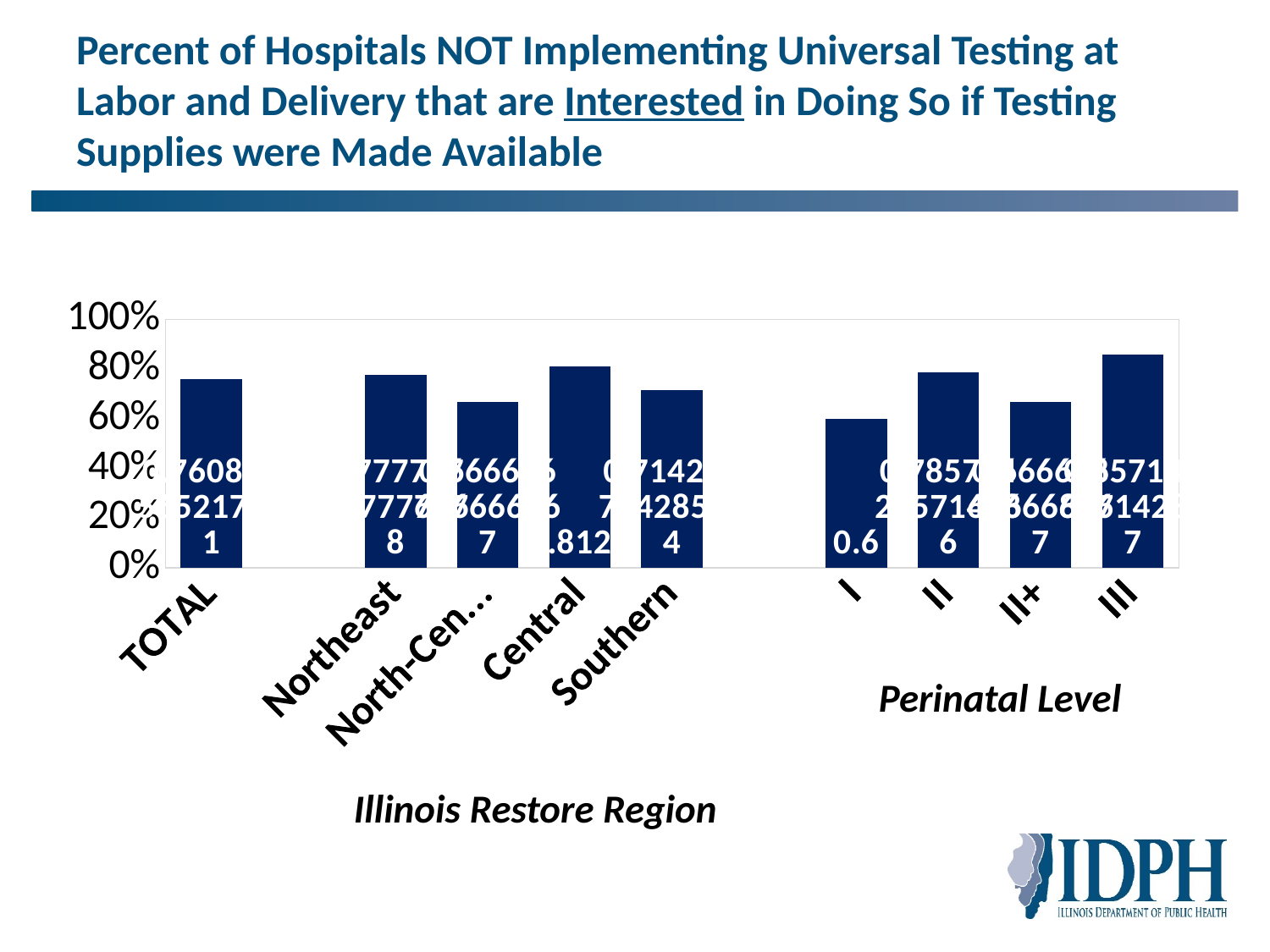
What kind of chart is shown on the slide? bar chart Is the value for Southern greater or less than 80%? less Which category has the highest value in the chart? III How many bars are plotted in the chart? 9 Which is larger, the value for Central or the value for Southern? Central Is the value for III greater or less than 80%? greater Which is larger, the value for Northeast or the value for North-Central? Northeast Is the value for I greater or less than 80%? less What is the highest percentage shown on the y axis of the chart? 100% What are the two group labels shown beneath the x axis of the chart? Illinois Restore Region and Perinatal Level Which category has the lowest value in the chart? I